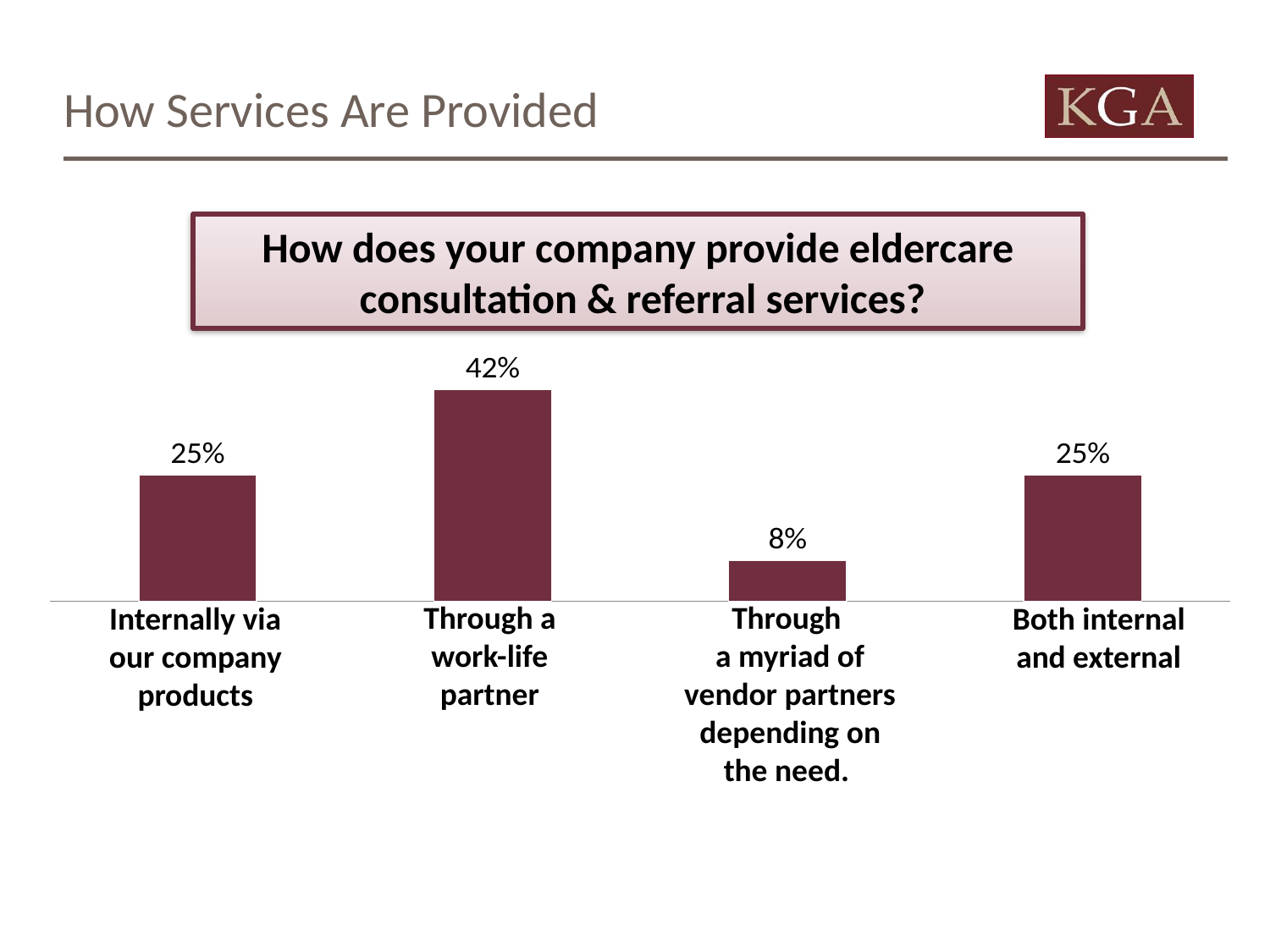
Which is larger: the value for 'Through a work-life partner' or the value for 'Internally via our company products'? Through a work-life partner What is the difference between the value for 'Internally via our company products' and the value for 'Through a myriad of vendor partners depending on the need.'? 17% Which category has the lowest value? Through a myriad of vendor partners depending on the need. What question does the chart answer, as shown in the box above it? How does your company provide eldercare consultation & referral services? How many categories are shown in the chart? 4 What is the value for 'Both internal and external'? 25% What is the value for 'Internally via our company products'? 25% What percentage is shown for 'Through a myriad of vendor partners depending on the need.'? 8% What kind of chart is shown on the slide? Bar chart What is the difference between the value for 'Through a work-life partner' and the value for 'Both internal and external'? 17% What percentage of companies provide eldercare consultation & referral services through a work-life partner? 42% Which category has the highest value? Through a work-life partner